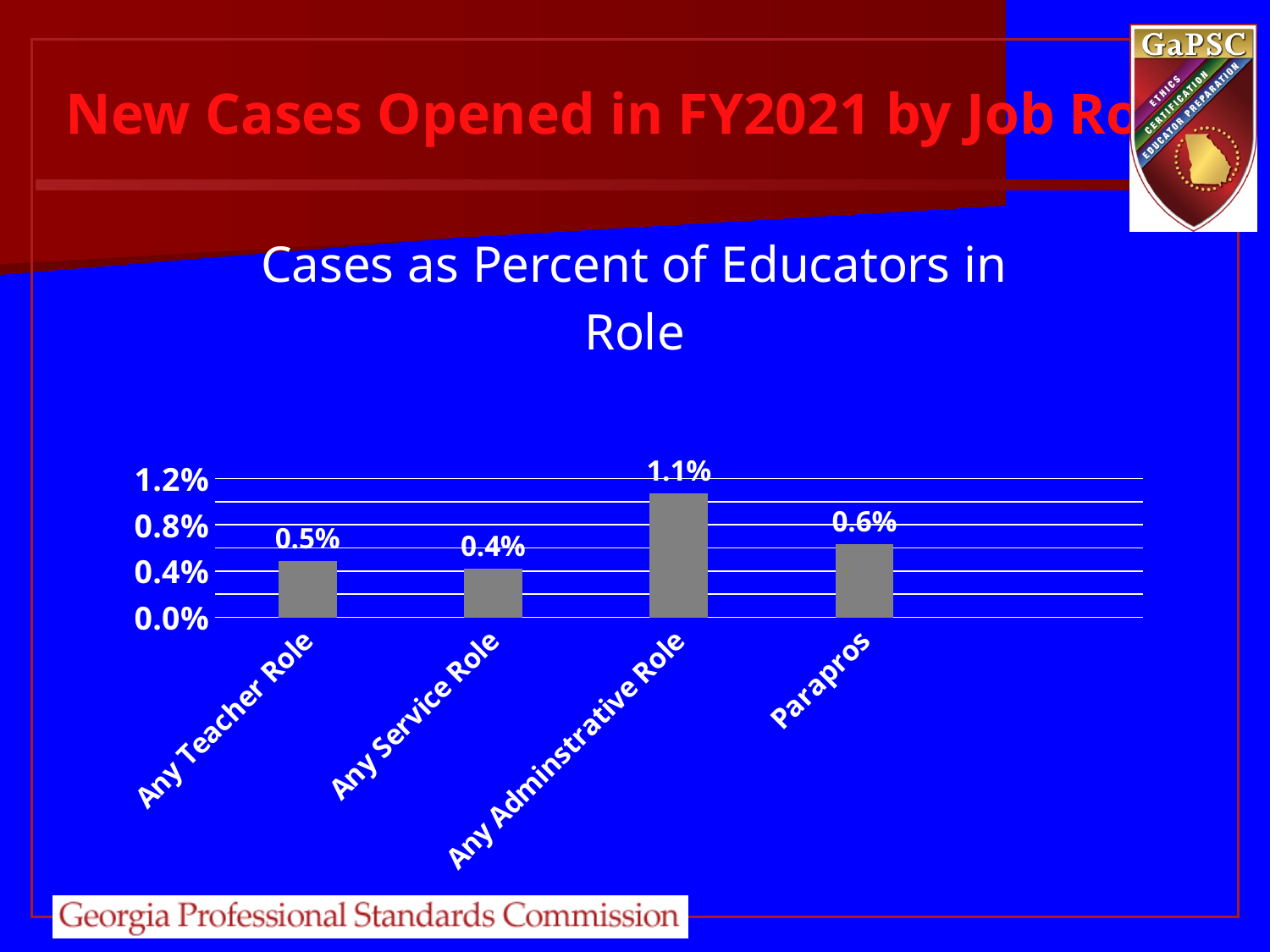
What is the value for Any Adminstrative Role? 1.1% What is the value for Any Teacher Role? 0.5% Which job role has the lowest percentage of cases? Any Service Role How many job role categories are shown in the chart? 4 Which is larger, the value for Parapros or the value for Any Teacher Role? Parapros What is the difference between the values for Any Adminstrative Role and Any Service Role? 0.7% Which job role has the highest percentage of cases? Any Adminstrative Role What is the title of the chart? Cases as Percent of Educators in Role What is the value for Any Service Role? 0.4% Is the value for Any Adminstrative Role greater or less than 0.8%? greater What is the value for Parapros? 0.6% What kind of chart is shown on the slide? Bar chart